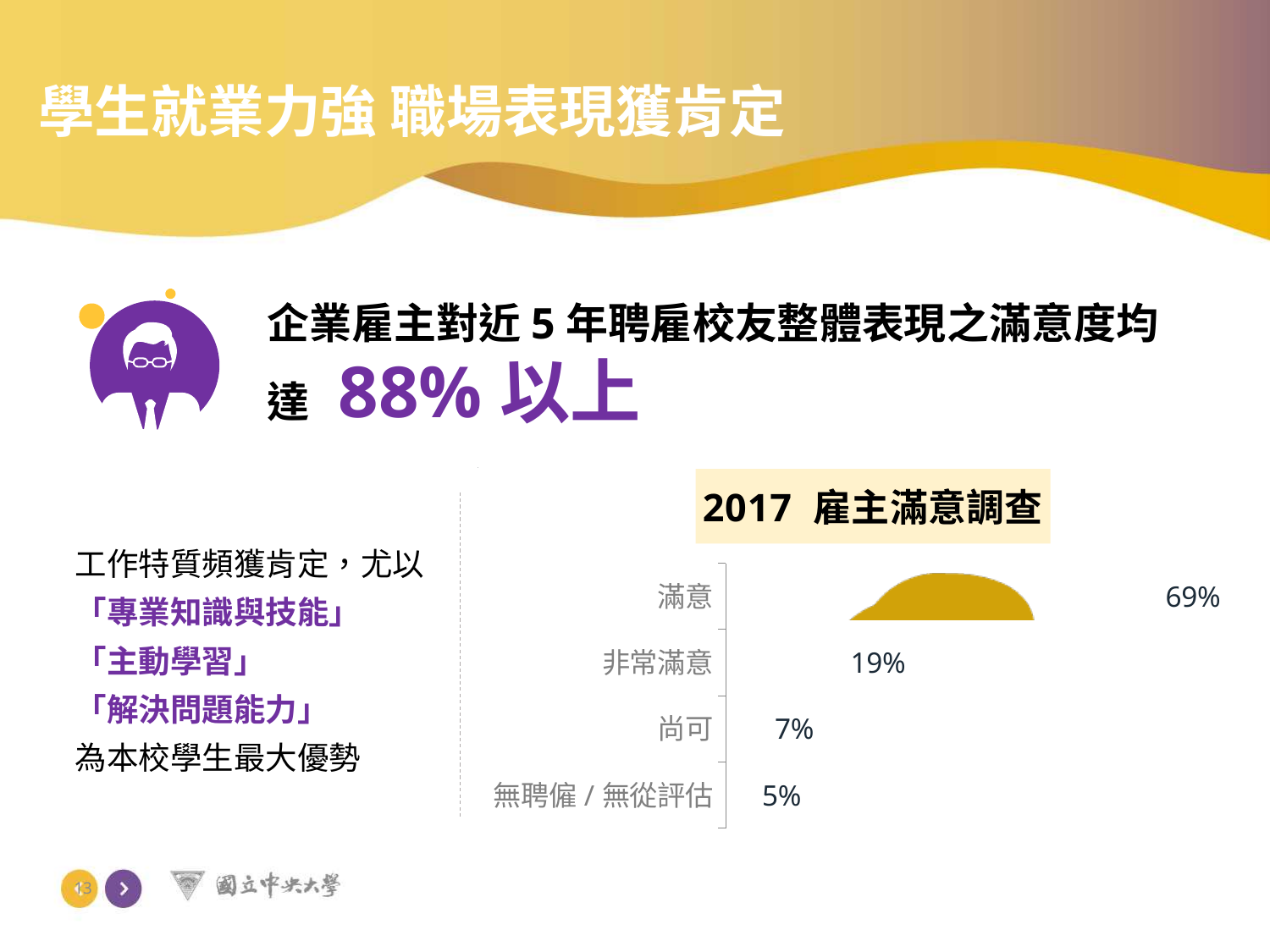
In the 2017 雇主滿意調查 chart, what is the difference between the values for 尚可 and 無聘僱 / 無從評估? 2% In the 2017 雇主滿意調查 chart, what is the value for 滿意? 69% How many categories are shown in the 2017 雇主滿意調查 chart? 4 In the 2017 雇主滿意調查 chart, which category has the highest value? 滿意 In the 2017 雇主滿意調查 chart, what is the value for 非常滿意? 19% In the 2017 雇主滿意調查 chart, what is the difference between the values for 滿意 and 非常滿意? 50% In the 2017 雇主滿意調查 chart, which is larger, the value for 非常滿意 or the value for 尚可? 非常滿意 In the 2017 雇主滿意調查 chart, which category has the lowest value? 無聘僱 / 無從評估 In the 2017 雇主滿意調查 chart, what is the value for 無聘僱 / 無從評估? 5% What kind of chart is the 2017 雇主滿意調查 chart? bar chart In the 2017 雇主滿意調查 chart, what is the value for 尚可? 7% What is the title of the chart on the slide? 2017 雇主滿意調查